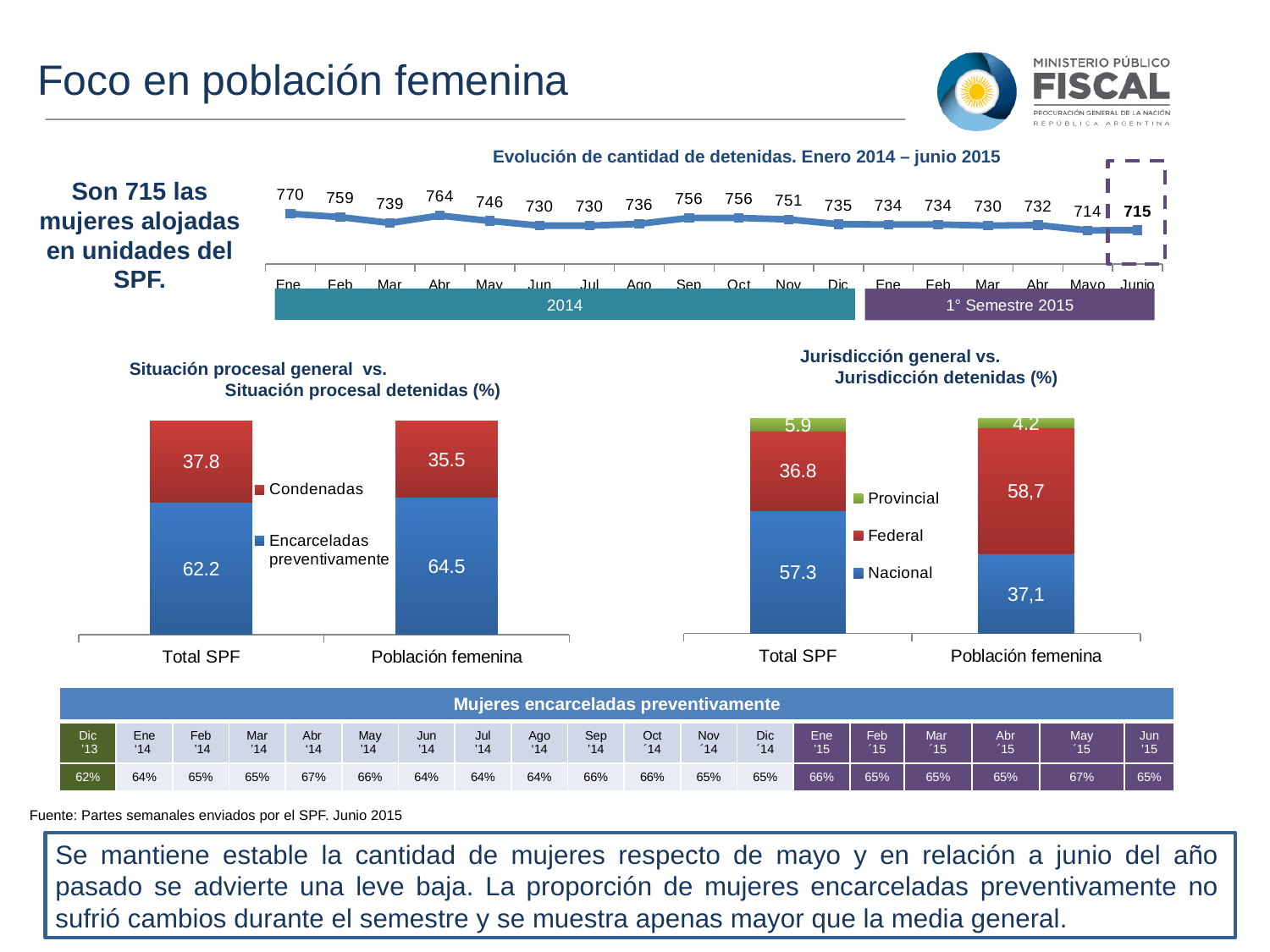
In the line chart 'Evolución de cantidad de detenidas', what is the value for Junio 2015? 715 In the chart 'Situación procesal general vs. Situación procesal detenidas (%)', what is the Condenadas value for Población femenina? 35.5 In the line chart 'Evolución de cantidad de detenidas', how many data points are plotted? 18 What kind of chart is 'Jurisdicción general vs. Jurisdicción detenidas (%)'? stacked bar chart In the chart 'Jurisdicción general vs. Jurisdicción detenidas (%)', what is the Federal value for Población femenina? 58,7 In the line chart 'Evolución de cantidad de detenidas', what is the value for Ene 2014? 770 In the line chart 'Evolución de cantidad de detenidas', which month has the lowest value? Mayo 2015 In the line chart 'Evolución de cantidad de detenidas', what is the difference between the Ene 2014 value and the Junio 2015 value? 55 In the line chart 'Evolución de cantidad de detenidas', which month has the highest value? Ene 2014 In the chart 'Situación procesal general vs. Situación procesal detenidas (%)', which is larger: Encarceladas preventivamente for Total SPF or for Población femenina? Población femenina In the chart 'Jurisdicción general vs. Jurisdicción detenidas (%)', how many series does the legend list? 3 In the line chart 'Evolución de cantidad de detenidas', do the values generally rise or fall from Ene 2014 to Junio 2015? fall